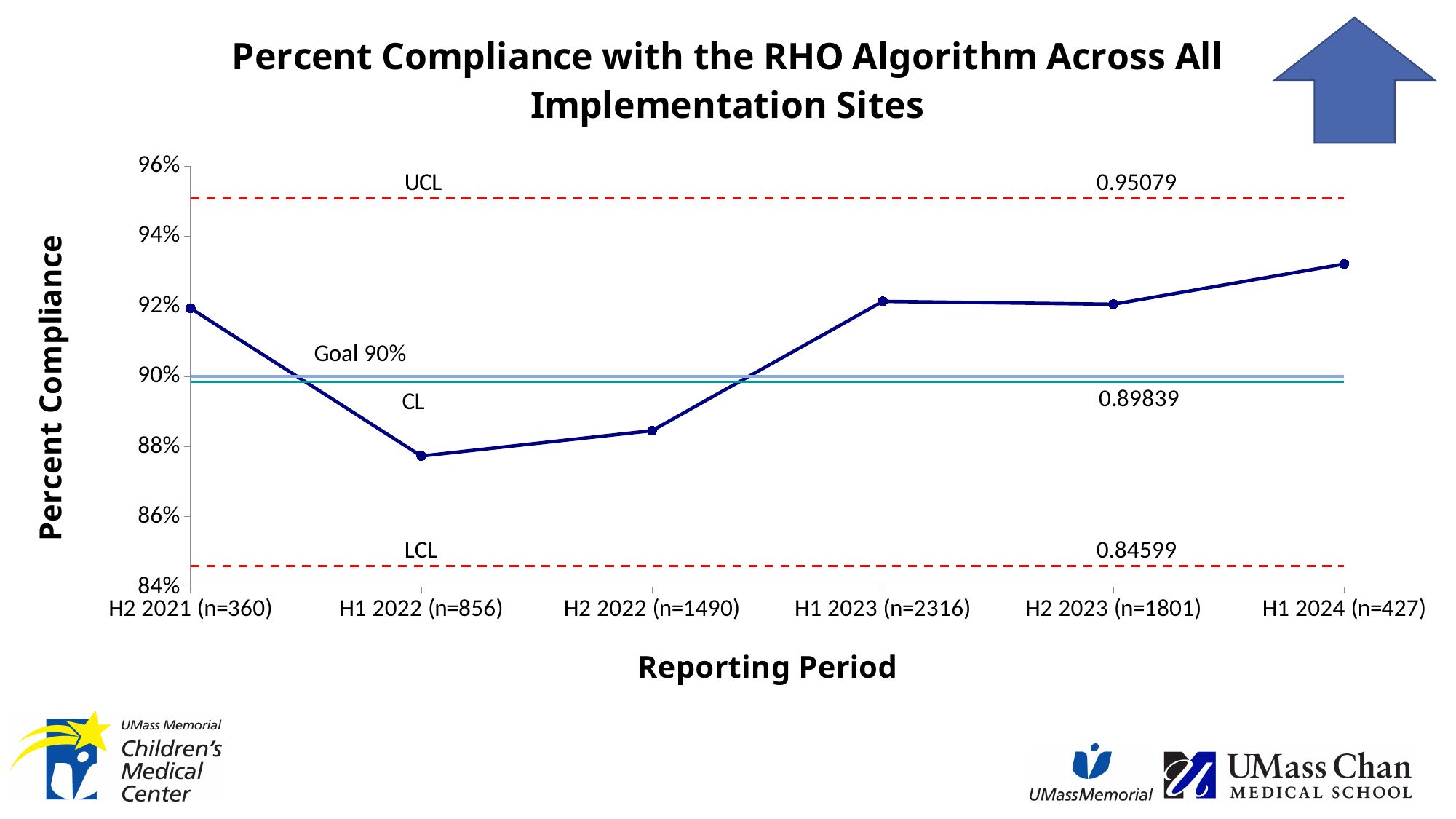
Is the percent compliance for H1 2022 (n=856) greater or less than 90%? less What value is printed for the CL line? 0.89839 What goal percentage is labelled on the chart? Goal 90% What value is printed for the UCL line? 0.95079 Which reporting period has the lowest percent compliance? H1 2022 (n=856) Does percent compliance rise or fall from H2 2022 (n=1490) to H1 2024 (n=427)? Rise What value is printed for the LCL line? 0.84599 How many reporting periods are plotted on the x axis? 6 Which has higher percent compliance, H2 2021 (n=360) or H2 2022 (n=1490)? H2 2021 (n=360) Is the percent compliance for H1 2024 (n=427) greater or less than 92%? greater What type of chart is shown on the slide? Line chart Which reporting period has the highest percent compliance? H1 2024 (n=427)